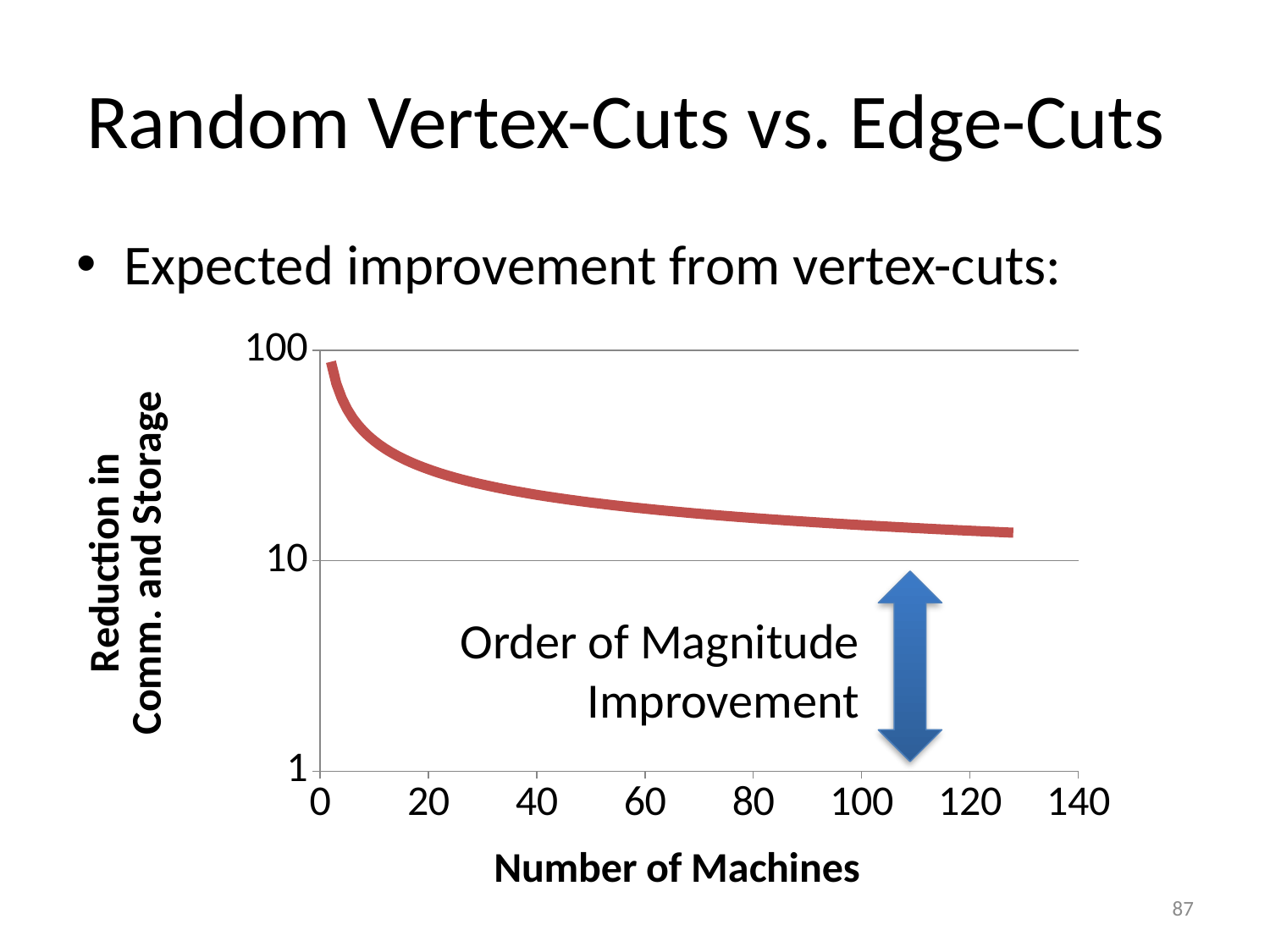
Does the plotted value rise or fall as the number of machines increases? fall Is the reduction in comm. and storage at 80 machines greater or less than 100? less Is the reduction in comm. and storage at 120 machines greater or less than 10? greater What is the label of the y axis? Reduction in Comm. and Storage What kind of chart is shown on the slide? line chart Is the plotted value higher at 20 machines or at 100 machines? 20 machines Is the reduction in comm. and storage at 40 machines greater or less than 100? less What is the label of the x axis? Number of Machines